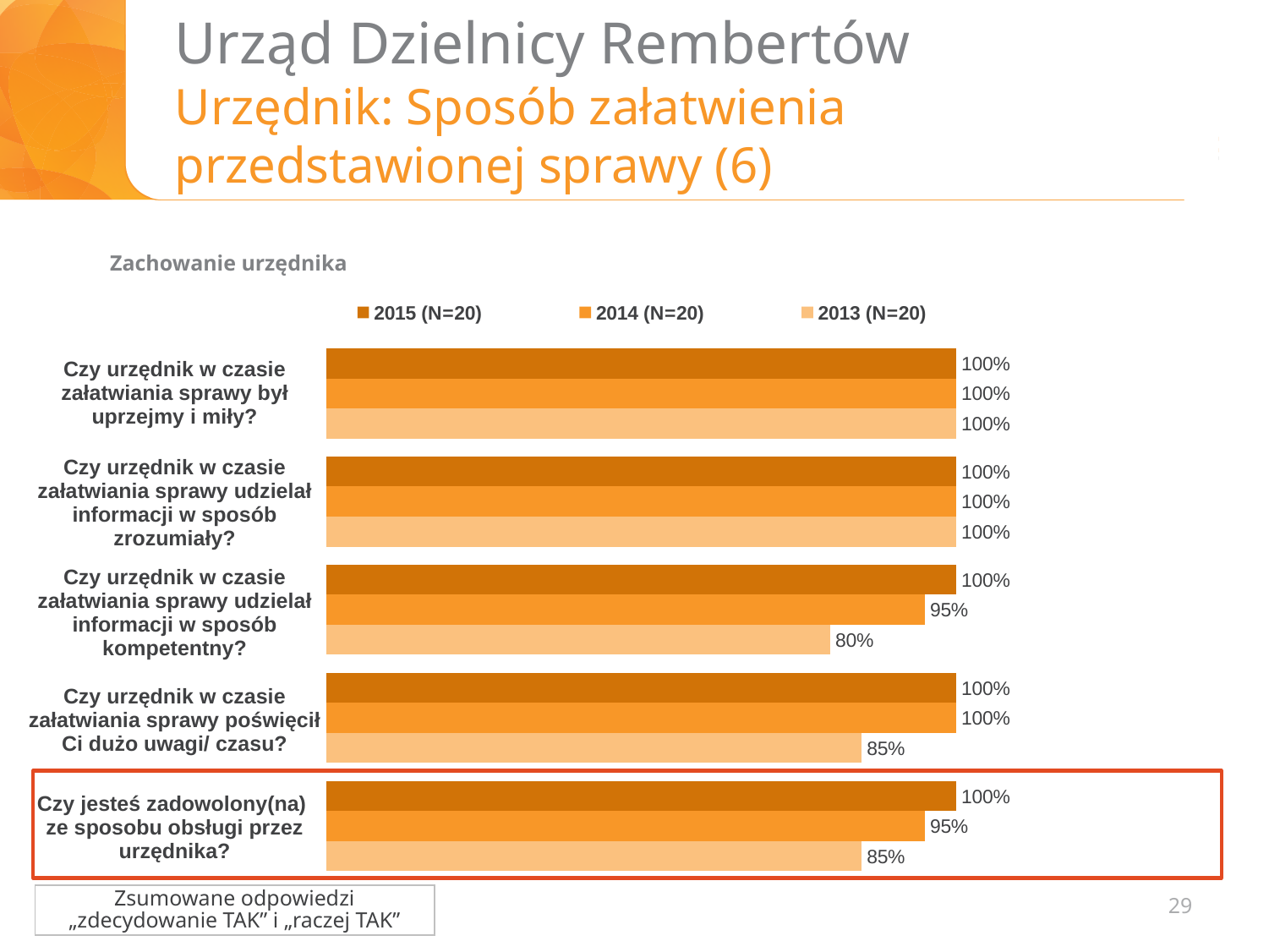
How many question categories are plotted on the chart? 5 Which year has the lowest value for "Czy urzędnik w czasie załatwiania sprawy udzielał informacji w sposób kompetentny?"? 2013 (N=20) Do the values for "Czy jesteś zadowolony(na) ze sposobu obsługi przez urzędnika?" rise or fall from 2013 to 2015? rise What is the 2013 (N=20) value for "Czy urzędnik w czasie załatwiania sprawy udzielał informacji w sposób kompetentny?"? 80% What is the difference between the 2015 and 2013 values for "Czy jesteś zadowolony(na) ze sposobu obsługi przez urzędnika?"? 15% What is the title shown above the chart? Zachowanie urzędnika How many series does the legend list? 3 What is the 2014 (N=20) value for "Czy jesteś zadowolony(na) ze sposobu obsługi przez urzędnika?"? 95% What is the 2015 (N=20) value for "Czy urzędnik w czasie załatwiania sprawy był uprzejmy i miły?"? 100% What type of chart is shown on the slide? bar chart For "Czy urzędnik w czasie załatwiania sprawy udzielał informacji w sposób kompetentny?", which is larger: the 2014 value or the 2013 value? 2014 (N=20) What is the 2013 (N=20) value for "Czy urzędnik w czasie załatwiania sprawy poświęcił Ci dużo uwagi/ czasu?"? 85%